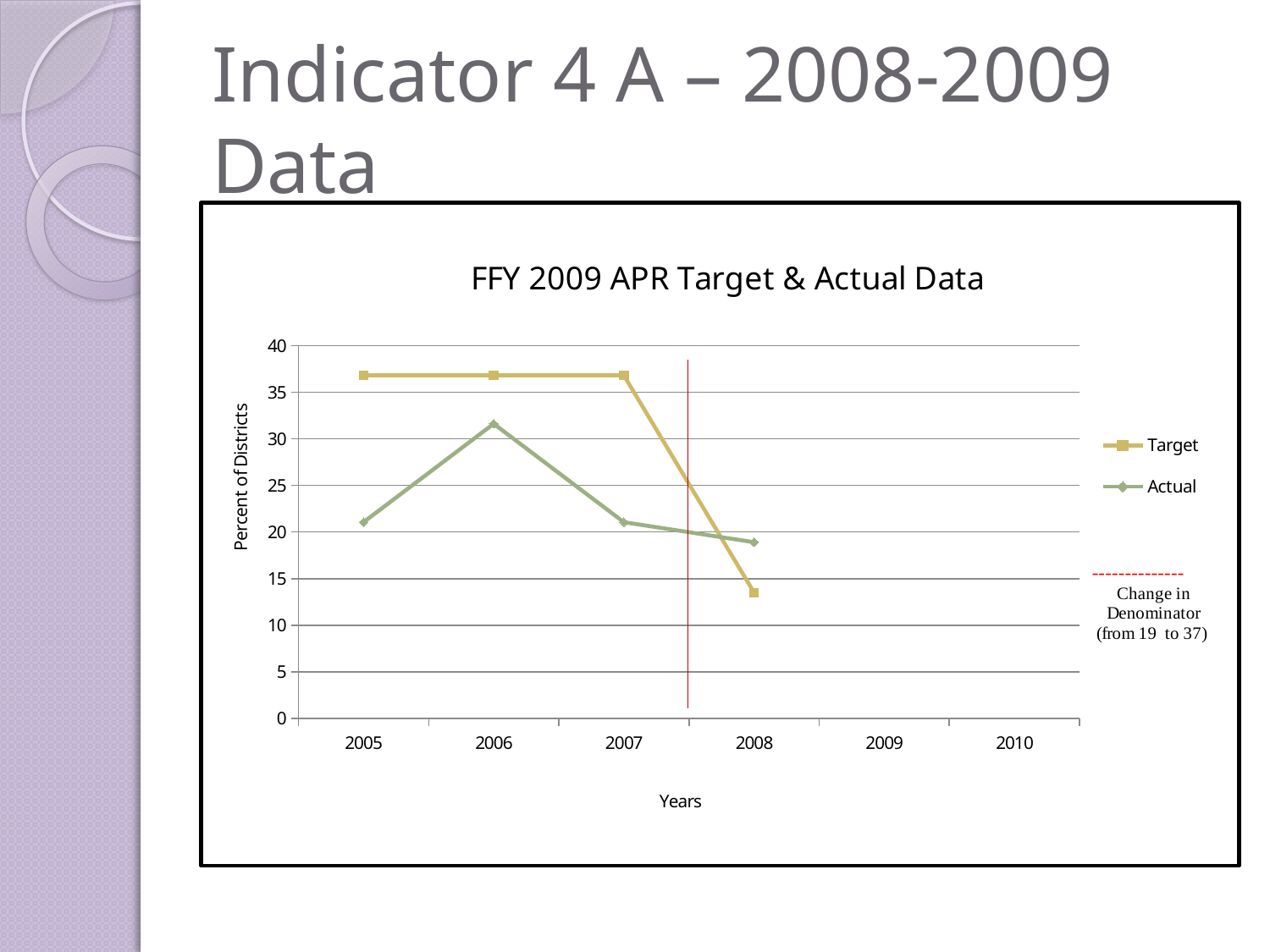
How many series does the legend list? 2 What is the title of the chart? FFY 2009 APR Target & Actual Data Is the Target value for 2008 greater or less than 15? less Which is larger in 2008, the Target value or the Actual value? Actual In which year is the Actual series at its highest? 2006 What kind of chart is shown on the slide? line chart Does the Target series rise or fall between 2007 and 2008? fall Is the Actual value for 2008 greater or less than 20? less In which year is the Target series at its lowest? 2008 Is the Actual value for 2006 greater or less than 30? greater What is the label on the vertical axis? Percent of Districts